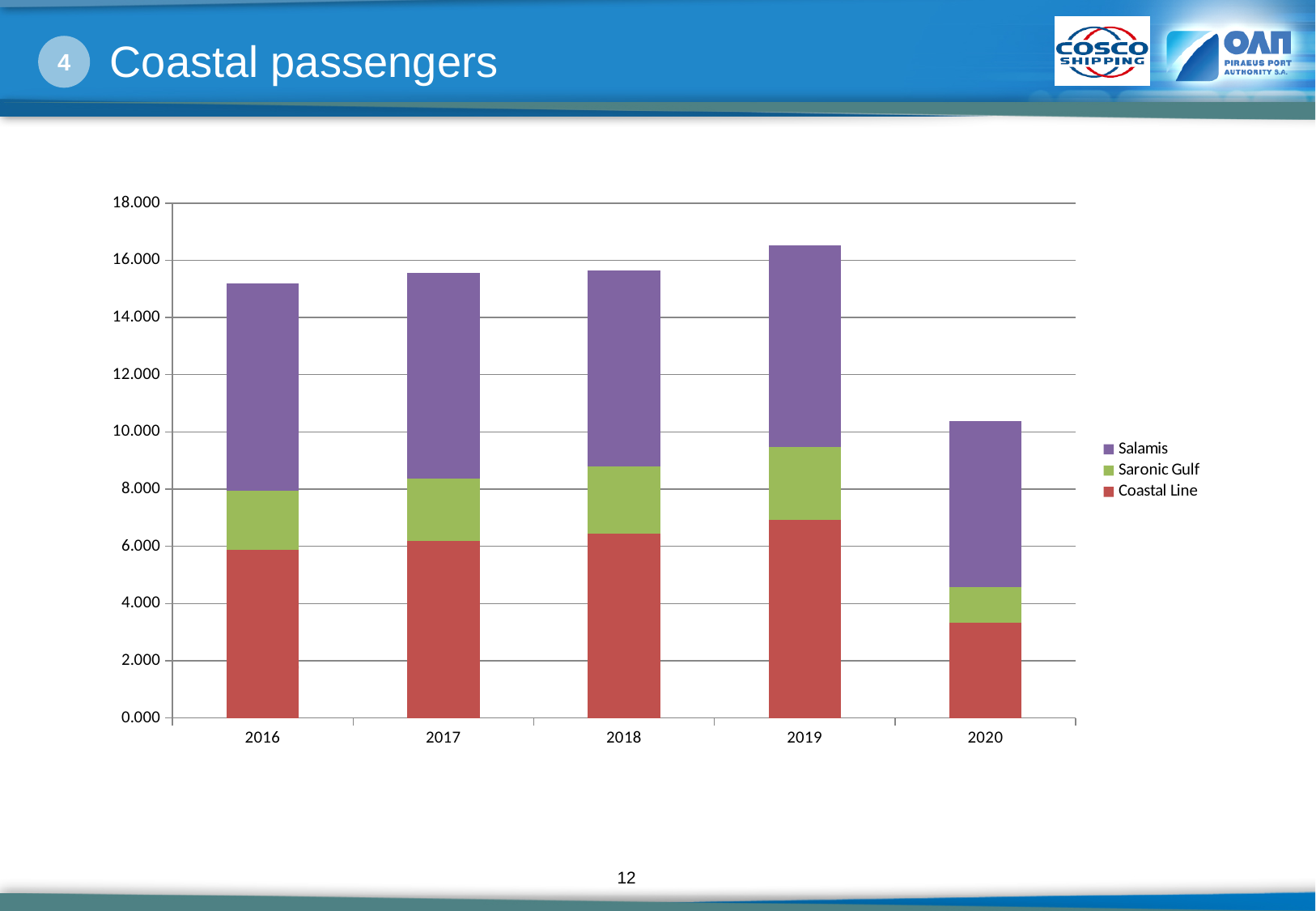
How many years are shown on the x axis of the chart? 5 Do the total stacked bars rise or fall from 2016 to 2019? rise What kind of chart is shown on the slide? stacked bar chart Which series is shown in purple in the chart? Salamis Is the Coastal Line value for 2019 greater or less than 6.000? greater Which is larger, the total stacked bar for 2019 or for 2020? 2019 Is the total stacked value for 2019 greater or less than 16.000? greater How many series does the chart's legend list? 3 Which year has the highest total stacked bar? 2019 Is the total stacked value for 2020 greater or less than 12.000? less Which year has the lowest total stacked bar? 2020